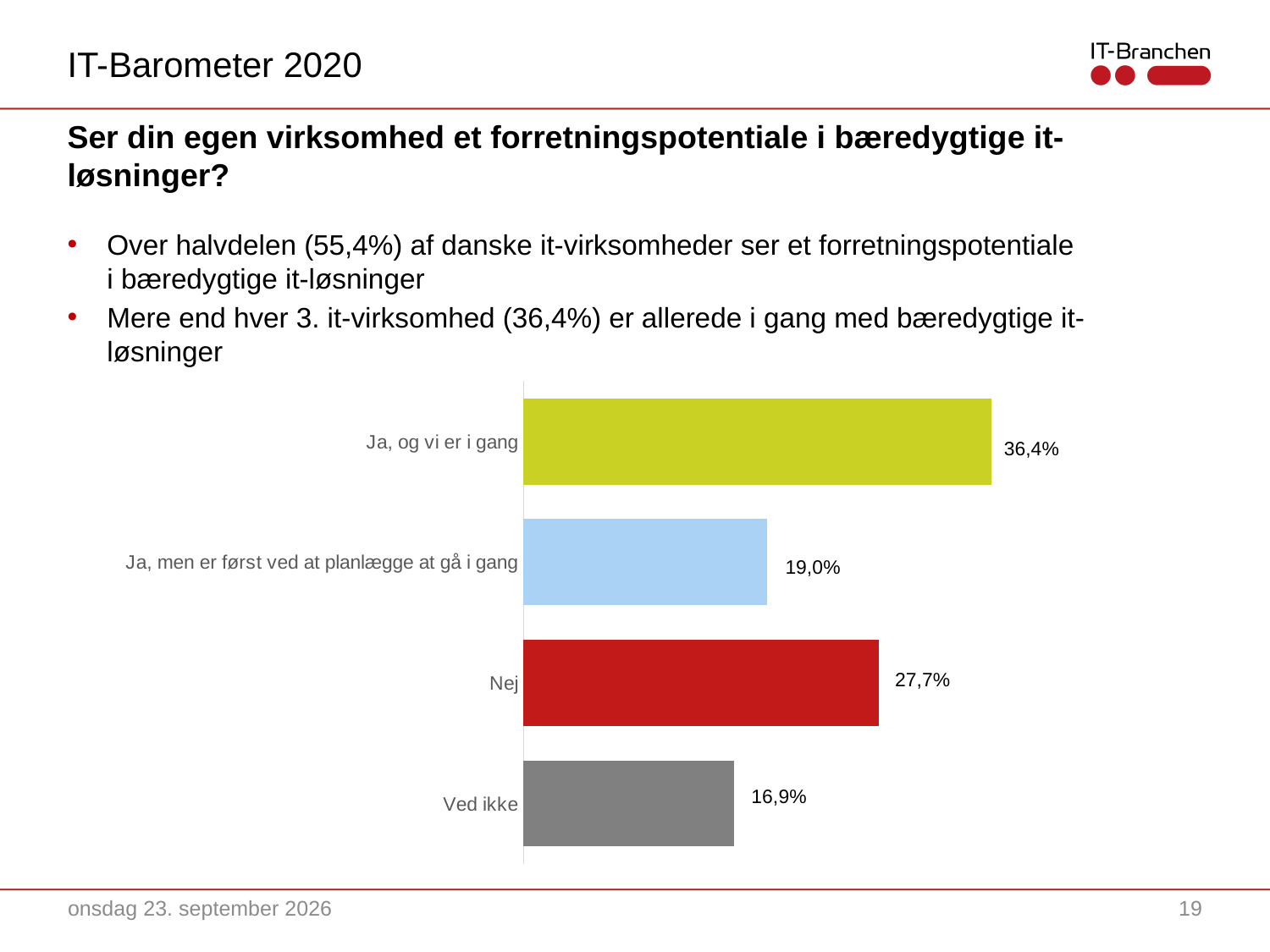
How many categories are shown in the chart? 4 What is the value for "Nej"? 27,7% Which is larger, the value for "Nej" or the value for "Ja, men er først ved at planlægge at gå i gang"? Nej What kind of chart is shown on the slide? Bar chart Which category has the lowest value? Ved ikke What is the difference between the values for "Ja, men er først ved at planlægge at gå i gang" and "Ved ikke"? 2,1% What is the difference between the values for "Ja, og vi er i gang" and "Nej"? 8,7% Which category has the highest value? Ja, og vi er i gang What colour is the bar for "Nej"? Red What is the value for "Ja, men er først ved at planlægge at gå i gang"? 19,0% What is the value for "Ja, og vi er i gang"? 36,4% What is the value for "Ved ikke"? 16,9%